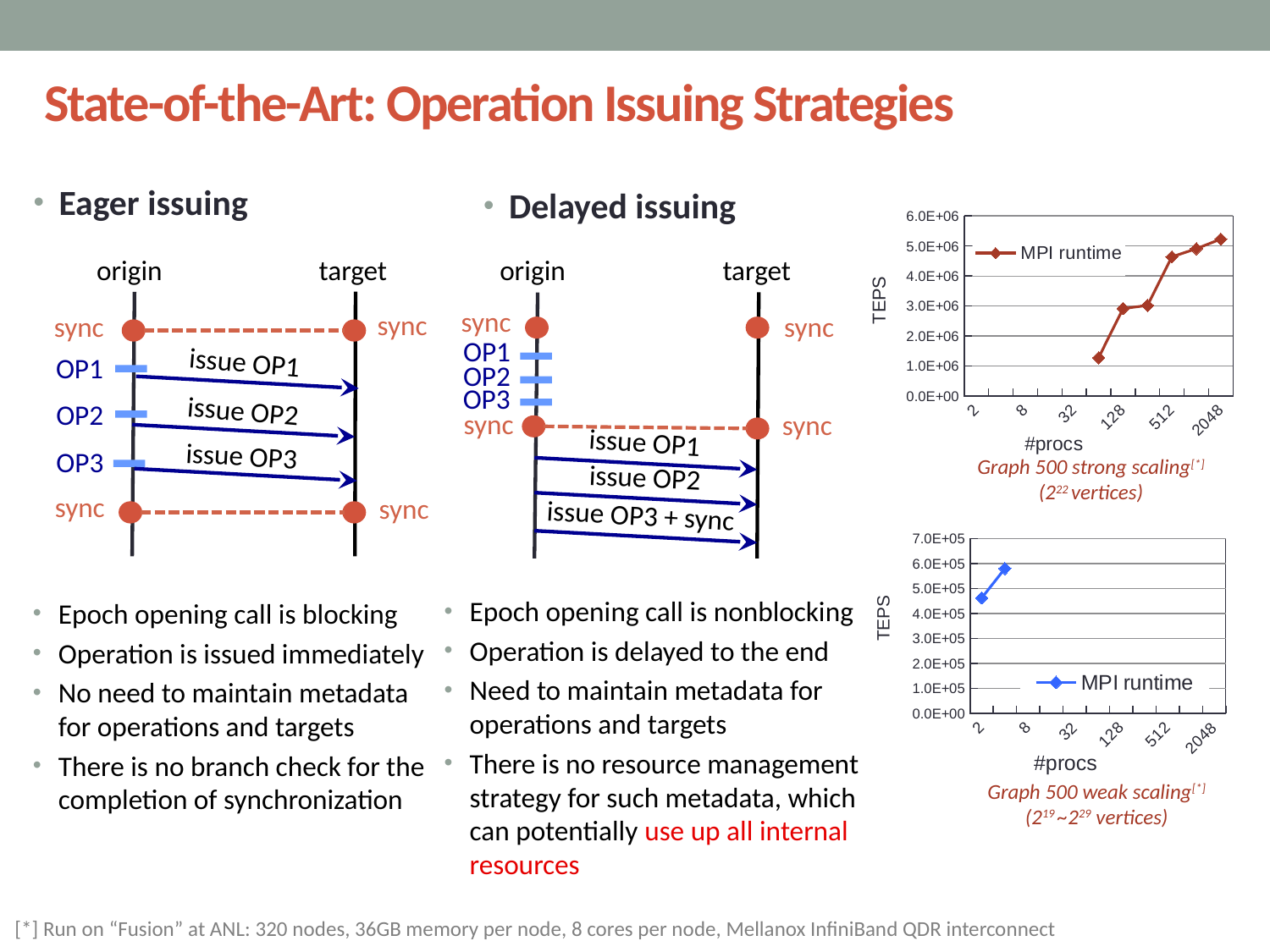
How many data points are plotted in the 'Graph 500 weak scaling' chart? 2 In the 'Graph 500 weak scaling' chart, do the TEPS values rise or fall as #procs increases? rise What is the name of the series shown in the 'Graph 500 weak scaling' chart? MPI runtime What kind of chart is the 'Graph 500 strong scaling' chart? line chart What kind of chart is the 'Graph 500 weak scaling' chart? line chart In the 'Graph 500 strong scaling' chart, is the TEPS value at 2048 procs greater or less than 4.0E+06? greater How many series does the legend of the 'Graph 500 strong scaling' chart list? 1 How many data points are plotted in the 'Graph 500 strong scaling' chart? 6 In the 'Graph 500 strong scaling' chart, do the TEPS values rise or fall as #procs increases? rise In the 'Graph 500 strong scaling' chart, is the TEPS value of the leftmost point greater or less than 2.0E+06? less What is the label of the y axis in the 'Graph 500 strong scaling' chart? TEPS In the 'Graph 500 weak scaling' chart, is the TEPS value of the first (leftmost) point greater or less than 5.0E+05? less